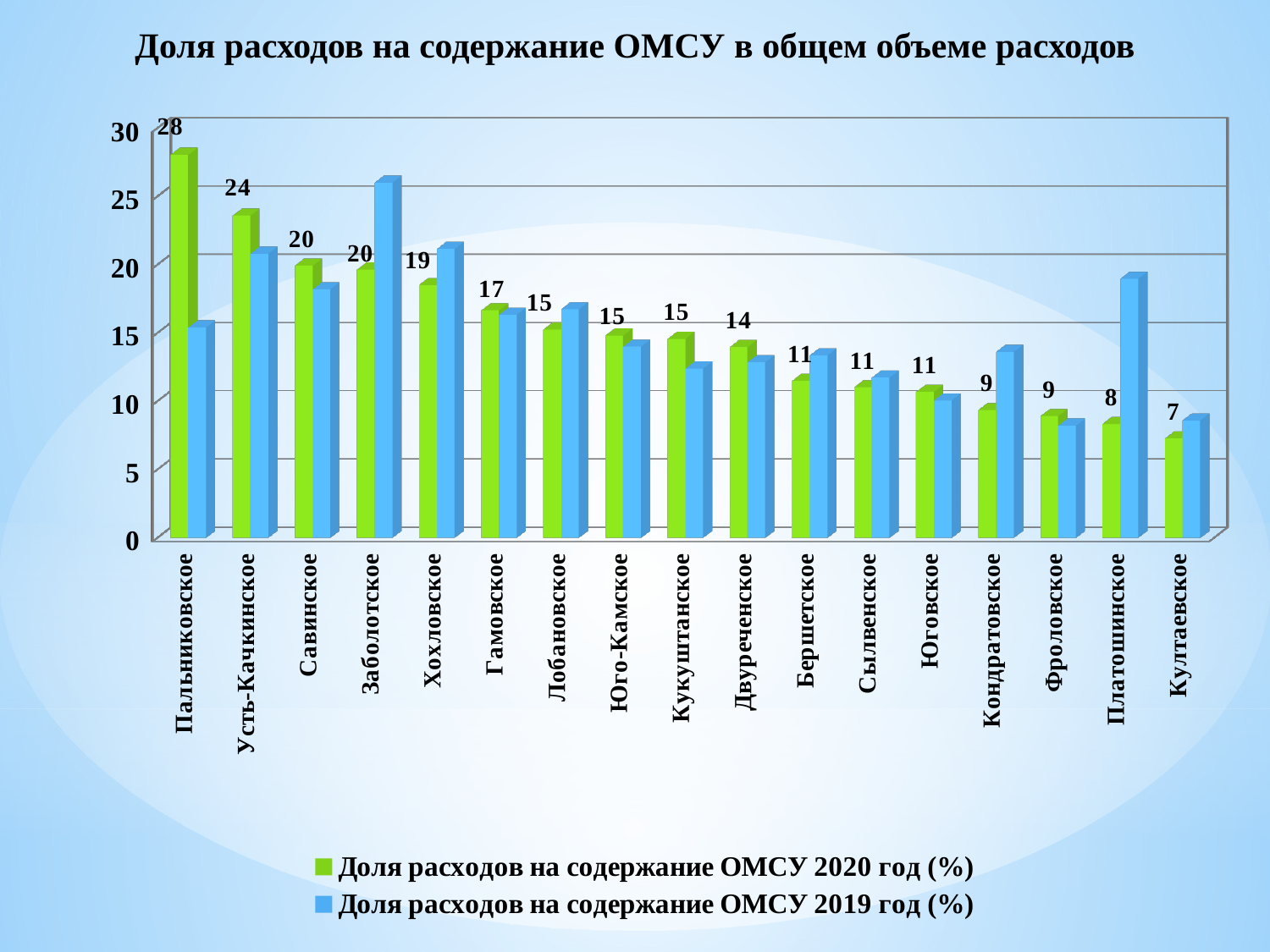
Is the 2019 value for Платошинское greater or less than 15? greater What kind of chart is shown on the slide? bar chart Which category has the lowest 2020 value? Култаевское Which category has the highest 2020 value? Пальниковское What is the difference between the 2020 values for Пальниковское and Усть-Качкинское? 4 How many series does the legend list? 2 What is the 2020 value for Усть-Качкинское? 24 How many categories are shown on the x axis? 17 Which is larger for Заболотское: the 2020 value or the 2019 value? 2019 What is the 2020 value for Култаевское? 7 What is the 2020 value (Доля расходов на содержание ОМСУ 2020 год) for Пальниковское? 28 Do the 2020 values rise or fall from left to right along the x axis? fall